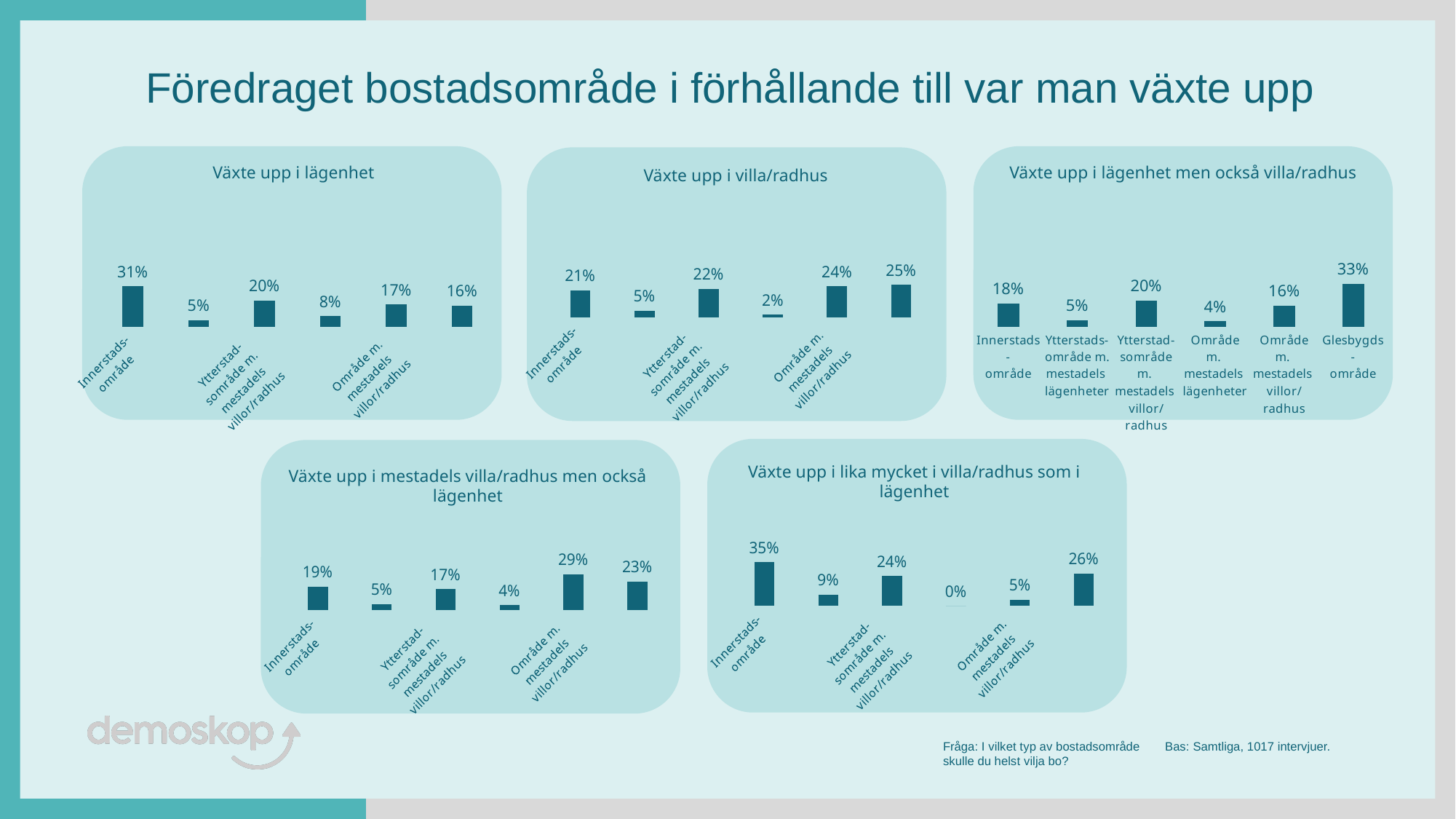
In the chart titled "Växte upp i lägenhet men också villa/radhus", what is the value for Ytterstadsområde m. mestadels lägenheter? 5% In the chart titled "Växte upp i lägenhet", what is the value for Innerstadsområde? 31% In the chart titled "Växte upp i lägenhet men också villa/radhus", how many categories are plotted? 6 In the chart titled "Växte upp i lika mycket i villa/radhus som i lägenhet", what is the value for Innerstadsområde? 35% In the chart titled "Växte upp i villa/radhus", what is the value for Ytterstadområde m. mestadels villor/radhus? 22% In the chart titled "Växte upp i lägenhet", which is larger: the value for Innerstadsområde or the value for Område m. mestadels villor/radhus? Innerstadsområde In the chart titled "Växte upp i mestadels villa/radhus men också lägenhet", what is the difference between the values for Område m. mestadels villor/radhus and Innerstadsområde? 10 percentage points In the chart titled "Växte upp i villa/radhus", what is the value for Område m. mestadels villor/radhus? 24% How many charts are shown on the slide? 5 What kind of chart is the chart titled "Växte upp i villa/radhus"? Bar chart In the chart titled "Växte upp i lägenhet men också villa/radhus", which category has the highest value? Glesbygdsområde In the chart titled "Växte upp i lägenhet men också villa/radhus", which category has the lowest value? Område m. mestadels lägenheter